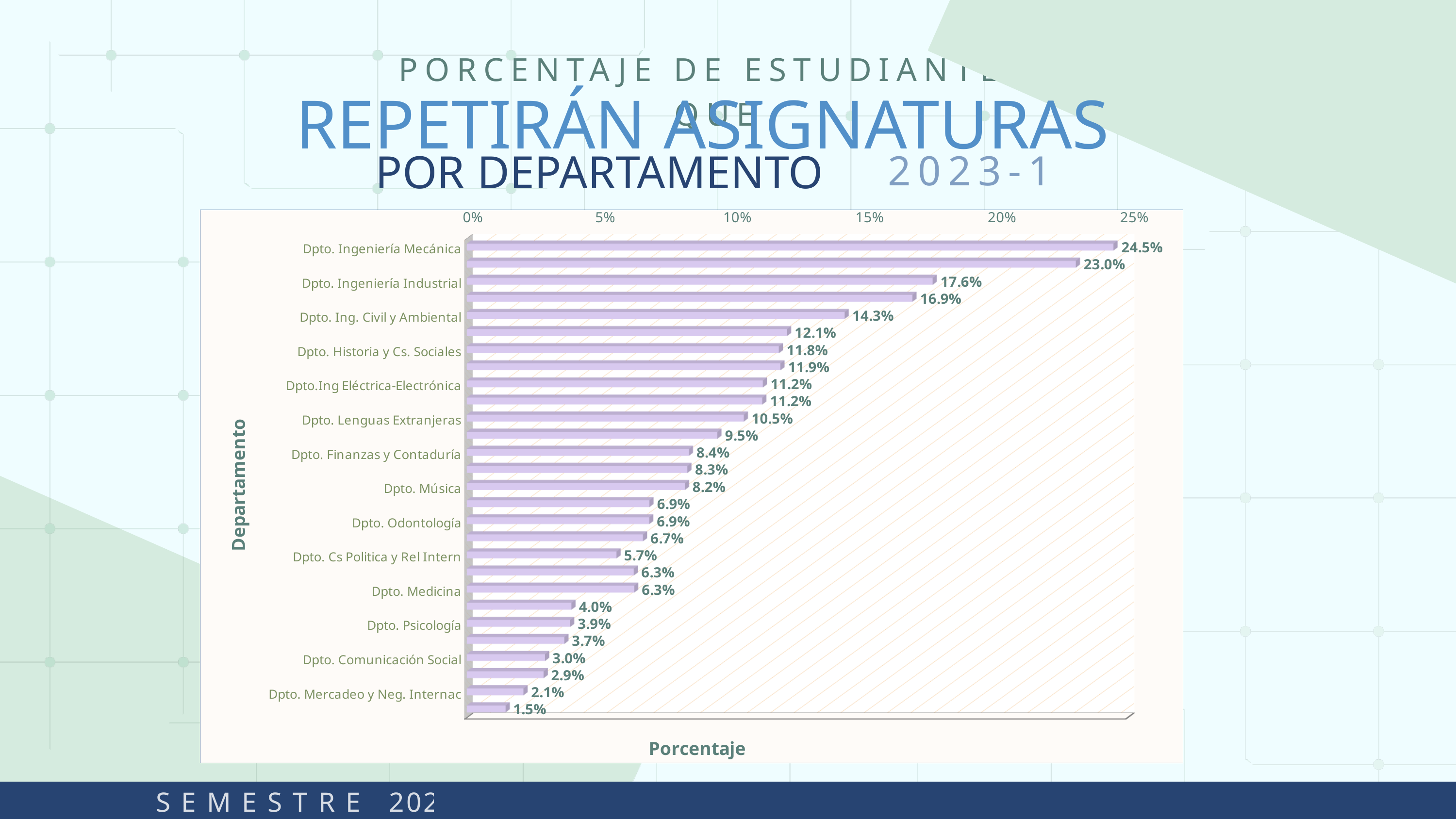
What is the value for Dpto. Ingeniería Industrial? 17.6% What is the value for Dpto. Ingeniería Mecánica? 24.5% What is the smallest value shown on the chart? 1.5% What is the value for Dpto. Psicología? 3.9% What is the title of the horizontal axis? Porcentaje Which labeled department has the highest percentage? Dpto. Ingeniería Mecánica What is the difference between the values for Dpto. Ingeniería Mecánica and Dpto. Ingeniería Industrial? 6.9% Which is larger, the value for Dpto. Música or the value for Dpto. Medicina? Dpto. Música What is the value for Dpto. Lenguas Extranjeras? 10.5% How many bars are plotted on the chart? 28 What type of chart is shown on the slide? bar chart Is the value for Dpto. Ing. Civil y Ambiental greater or less than 10%? greater